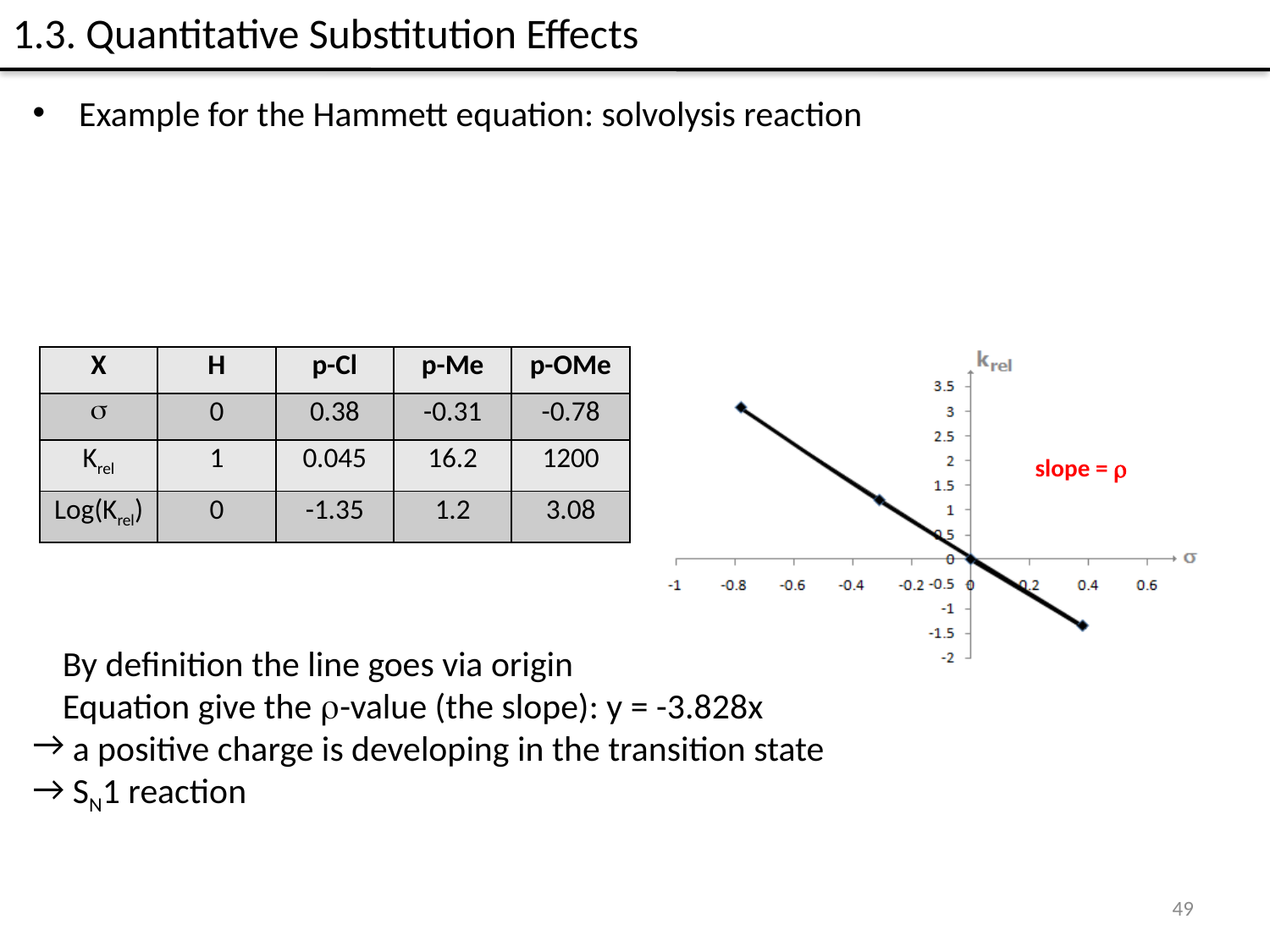
How many data points are plotted on the chart? 4 Is the value of the rightmost data point (near σ = 0.4) greater or less than 0? less Is the value of the data point near σ = -0.3 greater or less than 1? greater Is the value of the rightmost data point (near σ = 0.4) greater or less than -1? less What is the highest tick value shown on the vertical axis? 3.5 What is the label on the vertical axis of the chart? krel Do the plotted values rise or fall as σ increases along the x axis? Fall What is the y value of the data point that lies at the origin of the chart? 0 Which data point has the highest y value: the one at the far left or the one at the far right? The one at the far left What does the red annotation on the chart say the slope equals? ρ What kind of chart is shown on the slide? Scatter (line) chart